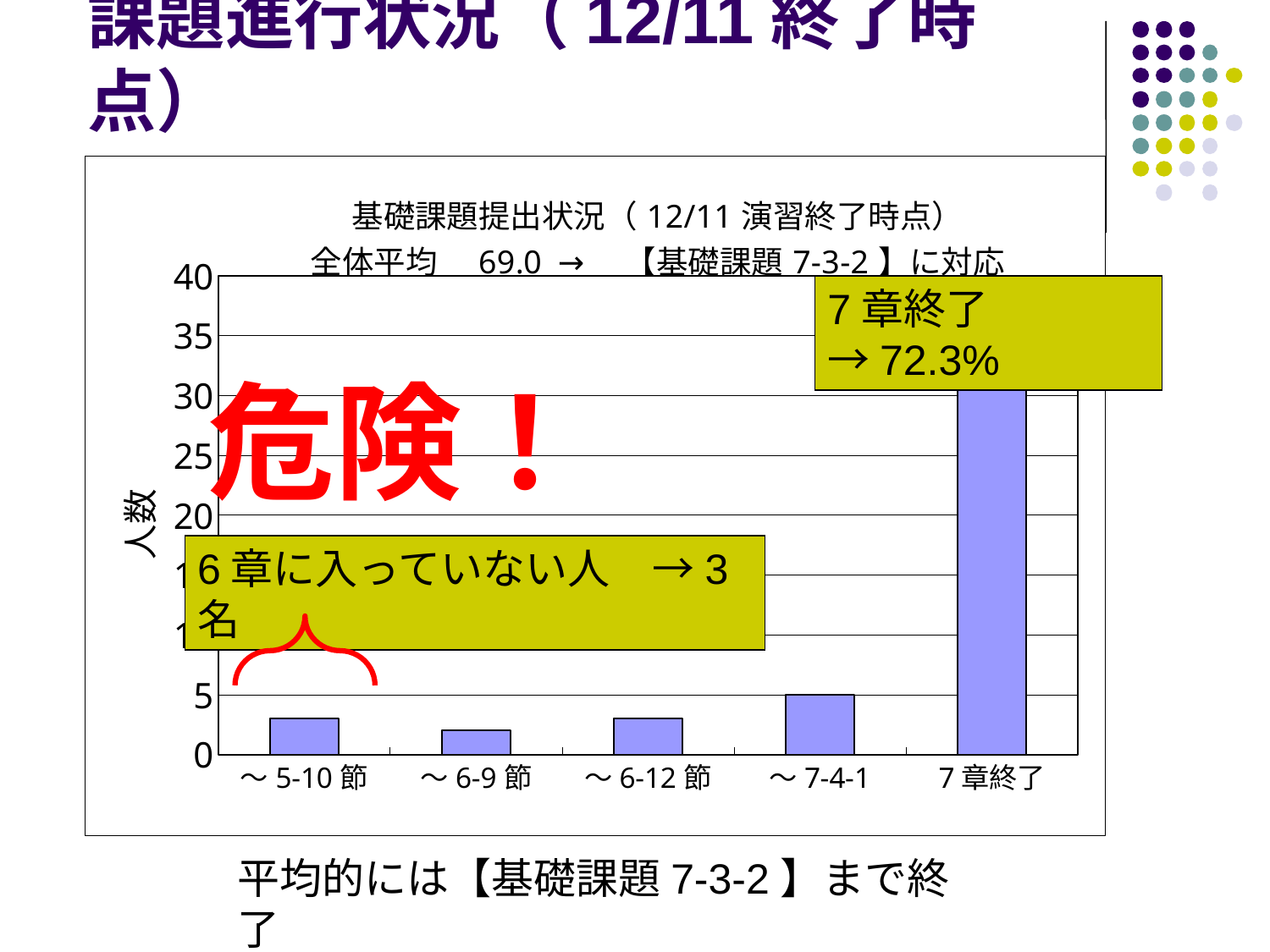
Is the value for ～7-4-1 greater or less than 10? less Which is larger, the value for ～7-4-1 or the value for ～6-9節? ～7-4-1 Which category has the lowest value in the chart? ～6-9節 Which is larger, the value for 7章終了 or the value for ～7-4-1? 7章終了 Which category has the highest value in the chart? 7章終了 What kind of chart is shown on the slide? bar chart What is the title of the chart? 基礎課題提出状況（12/11 演習終了時点） Is the value for 7章終了 greater or less than 30? greater Is the value for ～5-10節 greater or less than 5? less What is the label of the y axis of the chart? 人数 How many categories are shown on the x axis of the chart? 5